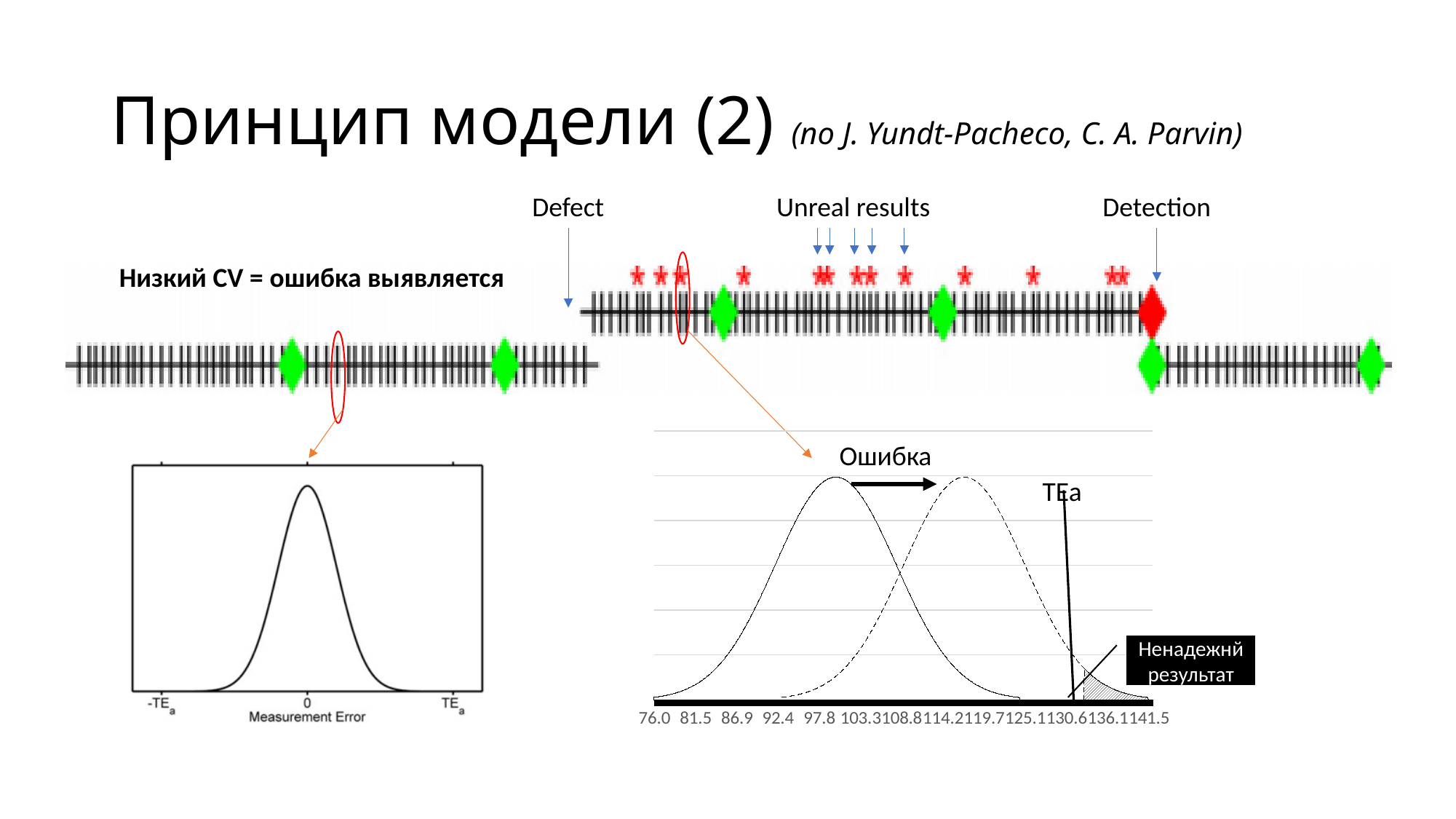
In the bottom-left chart, what is the title of the x axis? Measurement Error In the bottom-left chart, at which x-axis tick does the curve reach its peak? 0 In the bottom-left chart, how many tick labels are shown on the x axis? 3 What kind of chart is the bottom-right chart showing the two bell-shaped curves? line chart In the bottom-left chart, what are the leftmost and rightmost x-axis tick labels? -TEa and TEa In the bottom-right chart, which curve peaks further to the right, the solid curve or the dashed curve? the dashed curve In the bottom-right chart, what is the rightmost x-axis tick value? 141.5 What kind of chart is the bottom-left chart with the x-axis labelled 'Measurement Error'? line chart In the bottom-right chart, what is the leftmost x-axis tick value? 76.0 In the bottom-right chart, how many tick labels are printed on the x axis? 13 How many curves are plotted in the bottom-right chart? 2 In the bottom-right chart, what label is attached to the vertical line near the right side of the plot? TEa